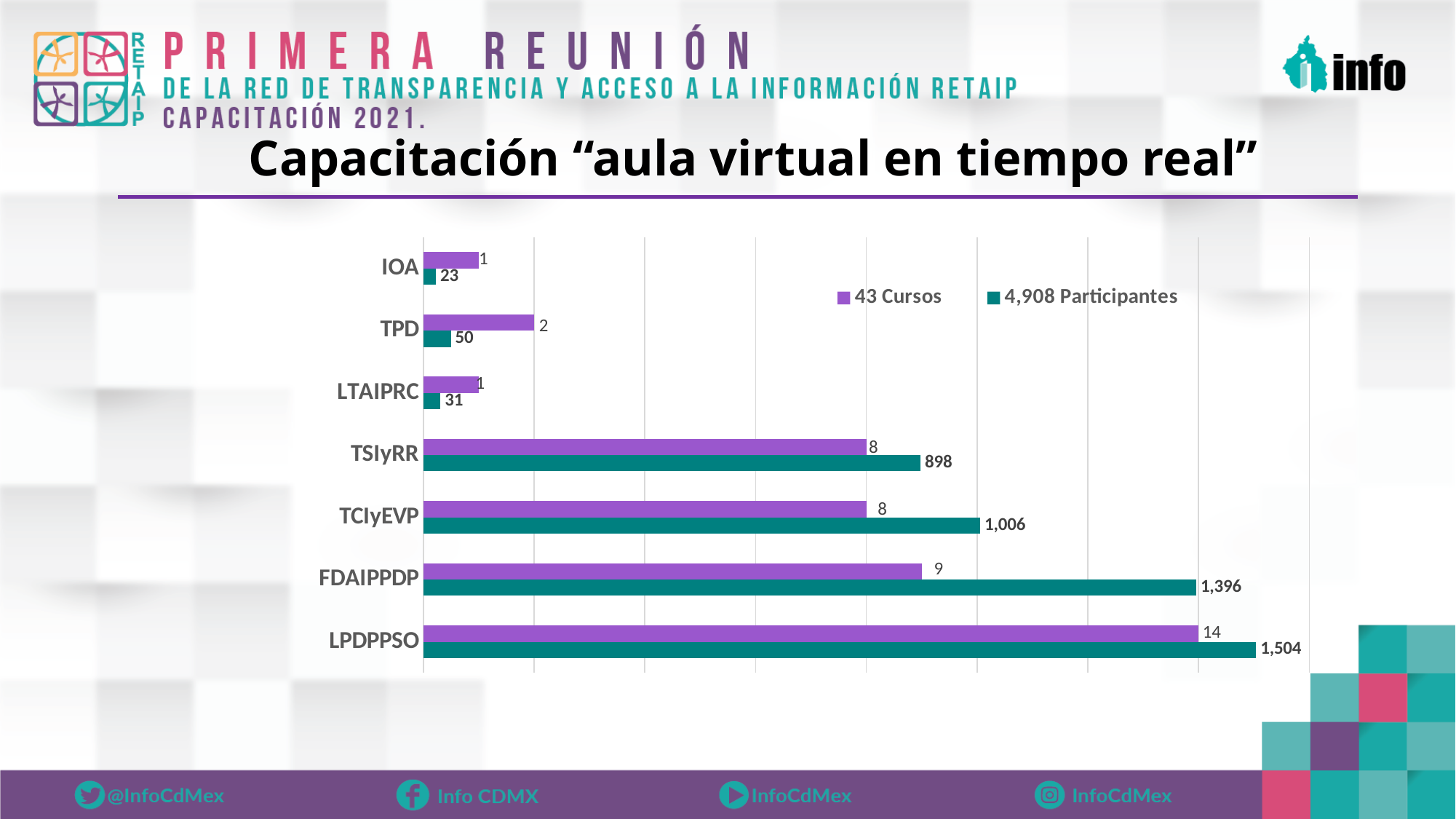
Which category has the highest number of participants (Participantes)? LPDPPSO Which has more participants (Participantes), TSIyRR or TCIyEVP? TCIyEVP How many categories are plotted on the chart? 7 What is the difference in courses (Cursos) between LPDPPSO and TPD? 12 How many participants (Participantes) are shown for LPDPPSO? 1,504 How many participants (Participantes) are shown for TPD? 50 What is the difference in participants (Participantes) between LPDPPSO and FDAIPPDP? 108 How many courses (Cursos) are shown for FDAIPPDP? 9 What kind of chart is shown on the slide? bar chart How many series does the legend list? 2 What are the two legend entries of the chart? 43 Cursos and 4,908 Participantes Which category has the lowest number of participants (Participantes)? IOA